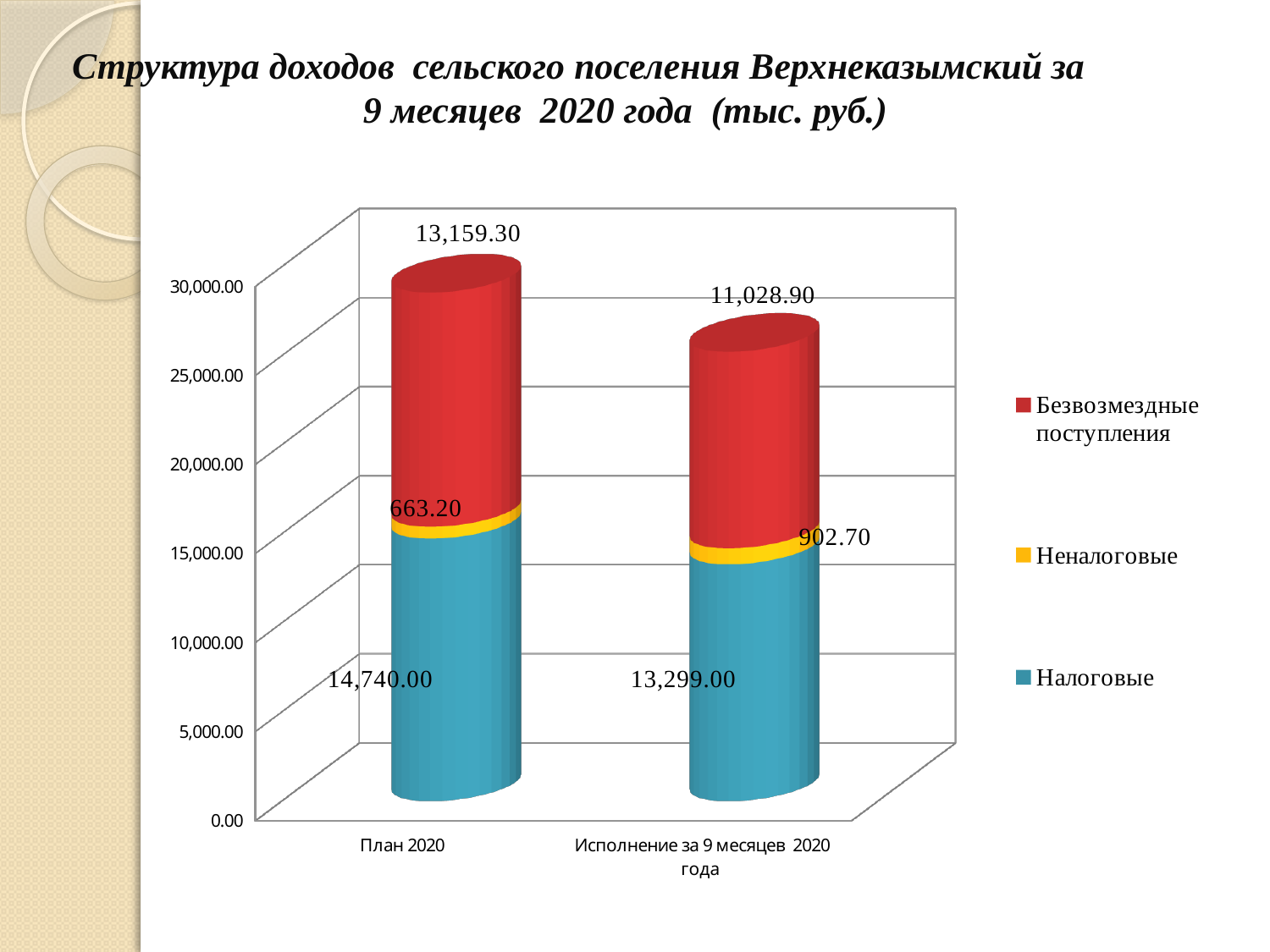
How many series does the legend list? 3 What is the value of Налоговые for План 2020? 14,740.00 What is the value of Неналоговые for План 2020? 663.20 What is the difference between the Неналоговые values for Исполнение за 9 месяцев 2020 года and План 2020? 239.50 What is the total of the stacked bar for План 2020? 28,562.50 What kind of chart is shown on the slide? Stacked bar chart What is the value of Безвозмездные поступления for Исполнение за 9 месяцев 2020 года? 11,028.90 What is the total of the stacked bar for Исполнение за 9 месяцев 2020 года? 25,230.60 What is the value of Неналоговые for Исполнение за 9 месяцев 2020 года? 902.70 How many categories are shown on the x axis? 2 What is the difference between the Налоговые values for План 2020 and Исполнение за 9 месяцев 2020 года? 1,441.00 Which category has the higher value for Безвозмездные поступления, План 2020 or Исполнение за 9 месяцев 2020 года? План 2020